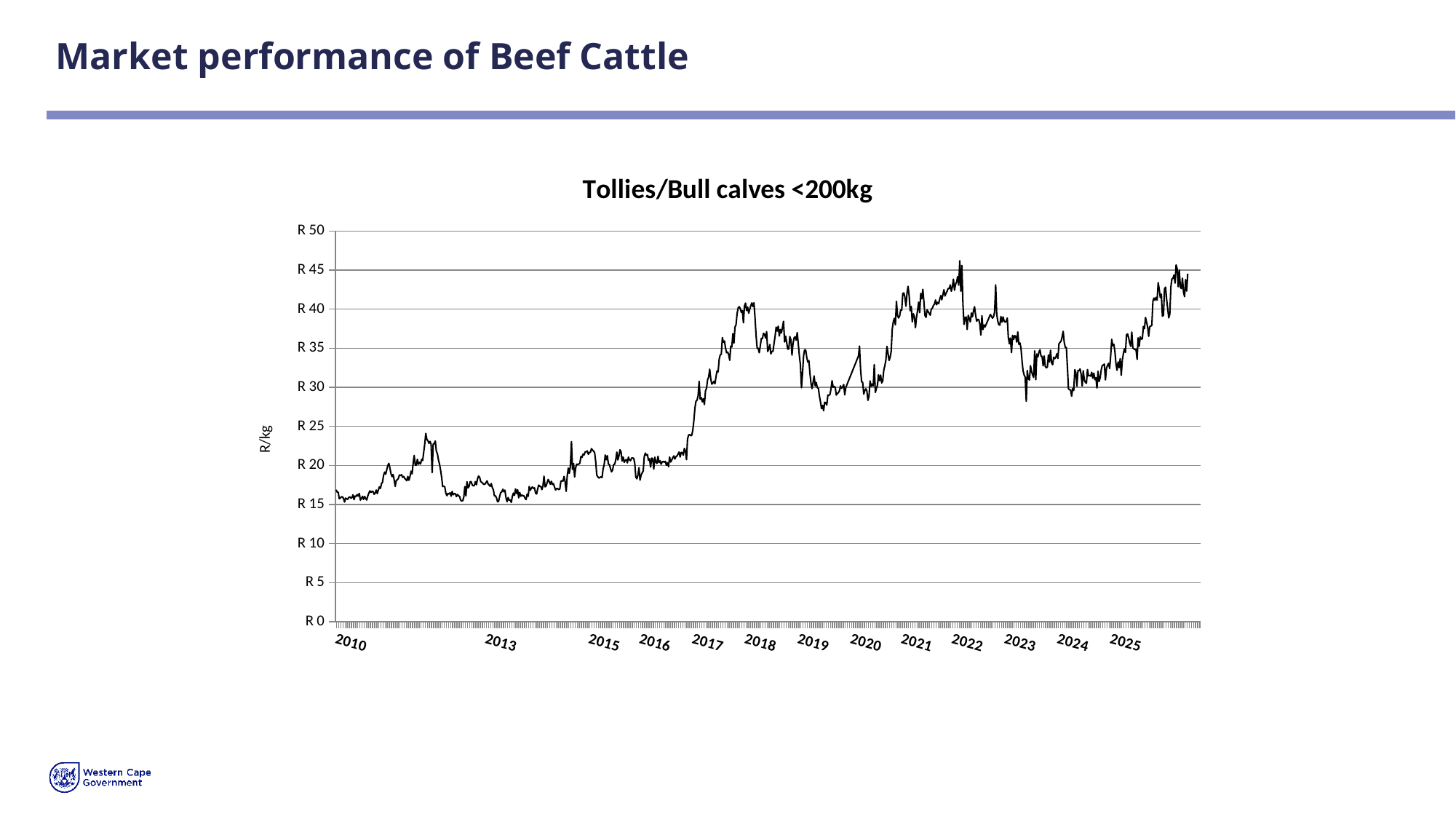
How many year labels are shown on the x axis? 13 Does the price rise or fall between 2018 and 2019? fall Is the value around 2013 greater or less than R 20? less Overall, does the price rise or fall from 2010 to 2025? rise Is the peak value around 2018 greater or less than R 35? greater Is the value at the end of 2025 larger than the value at the start of 2010? yes Is the lowest value around 2019 greater or less than R 30? less What kind of chart is shown on the slide? line chart What is the label on the vertical axis of the chart? R/kg What is the title of the chart? Tollies/Bull calves <200kg